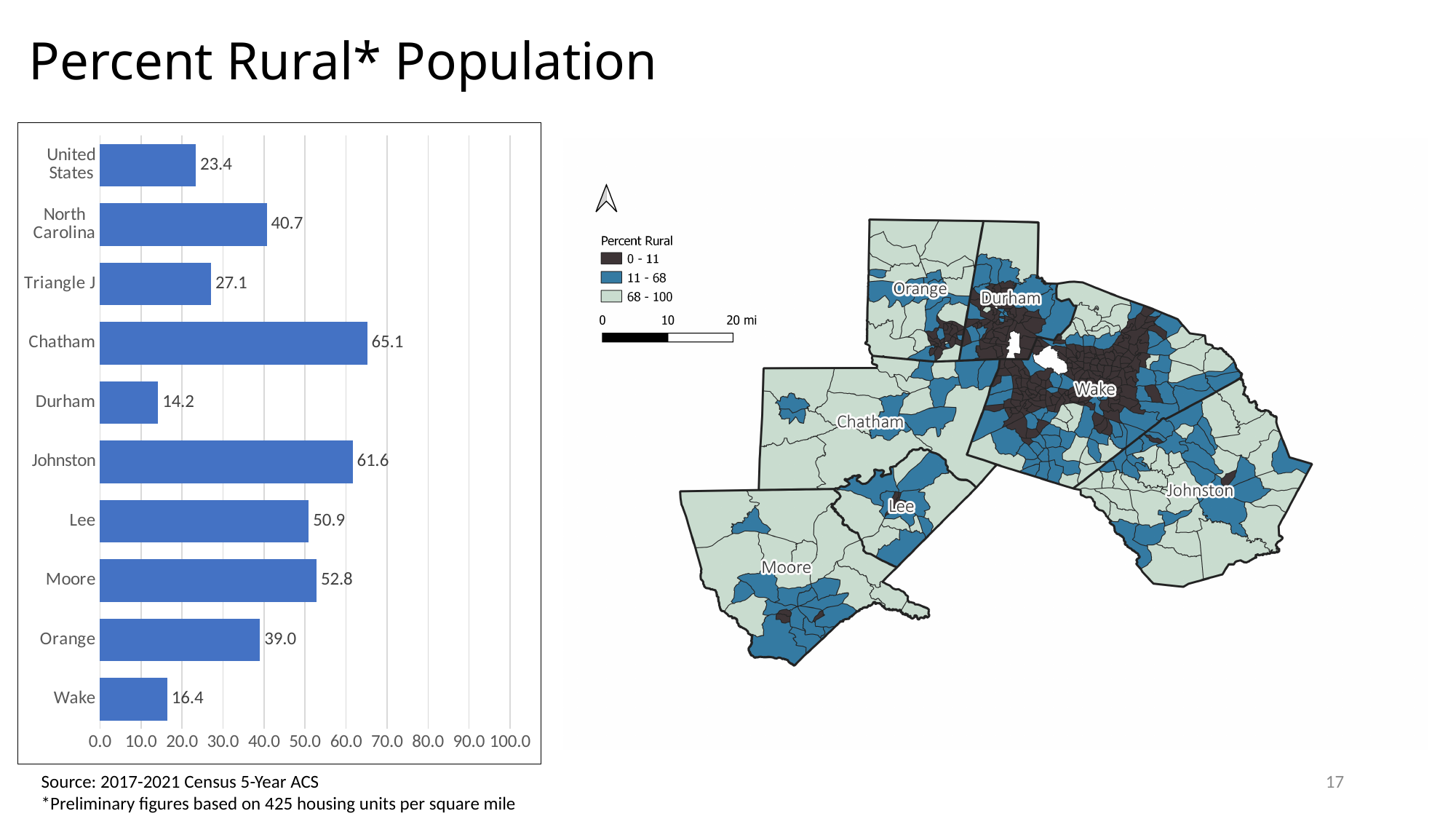
What is the difference between the values for North Carolina and the United States in the bar chart? 17.3 Which category has the highest value in the bar chart? Chatham What is the percent rural population value for Wake in the bar chart? 16.4 What is the percent rural population value for Chatham in the bar chart? 65.1 What is the title of the slide? Percent Rural* Population What is the difference between the values for Johnston and Lee in the bar chart? 10.7 What kind of chart is shown on the left of the slide? bar chart Is the value for Triangle J in the bar chart greater or less than 30.0? less How many categories are shown in the bar chart? 10 Which has a larger value in the bar chart, Moore or Orange? Moore Which category has the lowest value in the bar chart? Durham What is the percent rural population value for North Carolina in the bar chart? 40.7